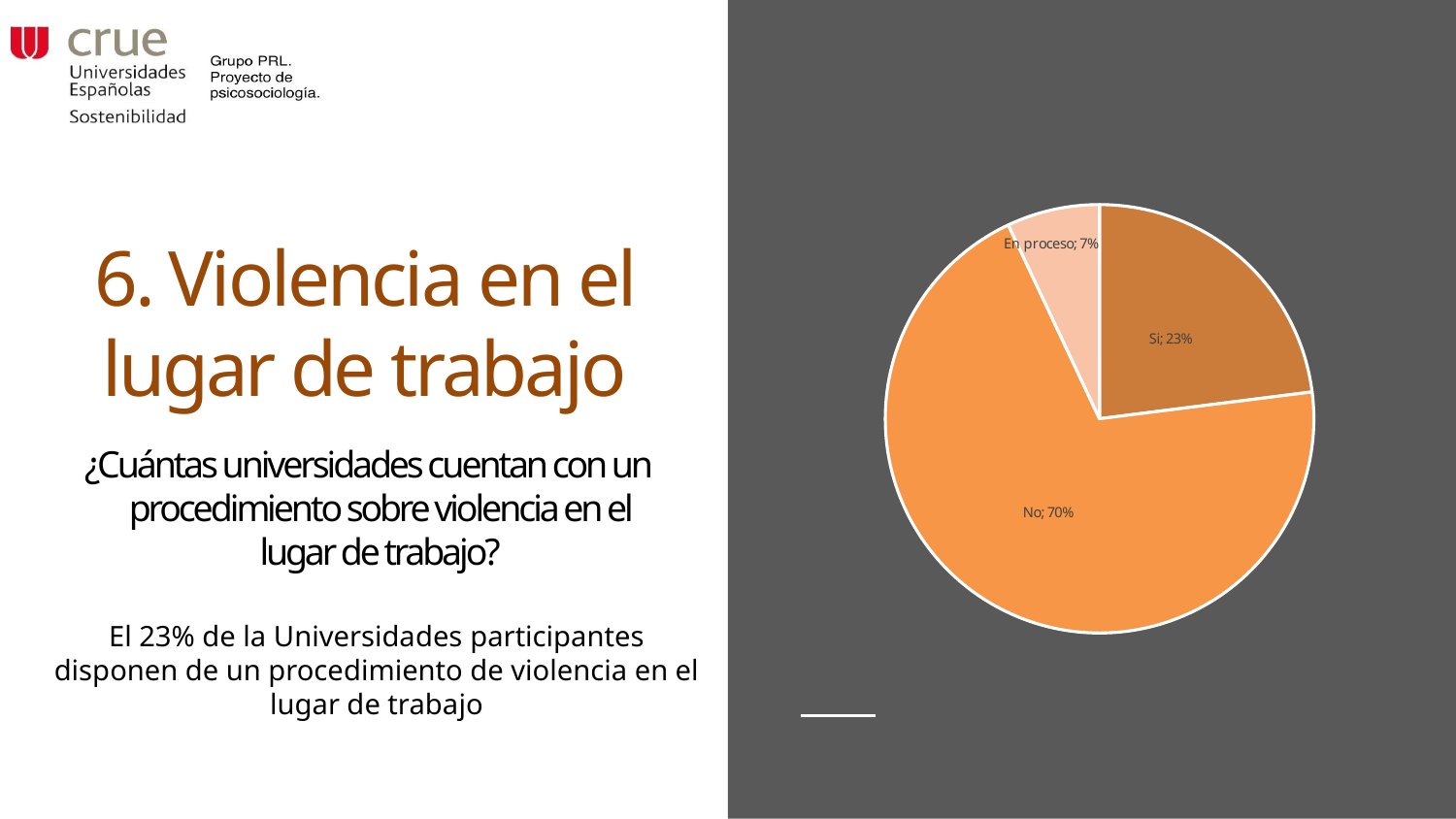
How many slices does the pie chart have? 3 What kind of chart is shown on the slide? pie chart Which slice of the pie is the smallest? En proceso What is the difference in percentage points between the "Si" slice and the "En proceso" slice? 16 What share of the pie does the "Si" slice represent? 23% Which slice of the pie is the largest? No Which is larger, the "Si" slice or the "En proceso" slice? Si What share of the pie does the "En proceso" slice represent? 7% What colour is the "No" slice of the pie? orange What is the difference in percentage points between the "No" slice and the "Si" slice? 47 Is the value for "No" greater or less than 50%? greater What share of the pie does the "No" slice represent? 70%